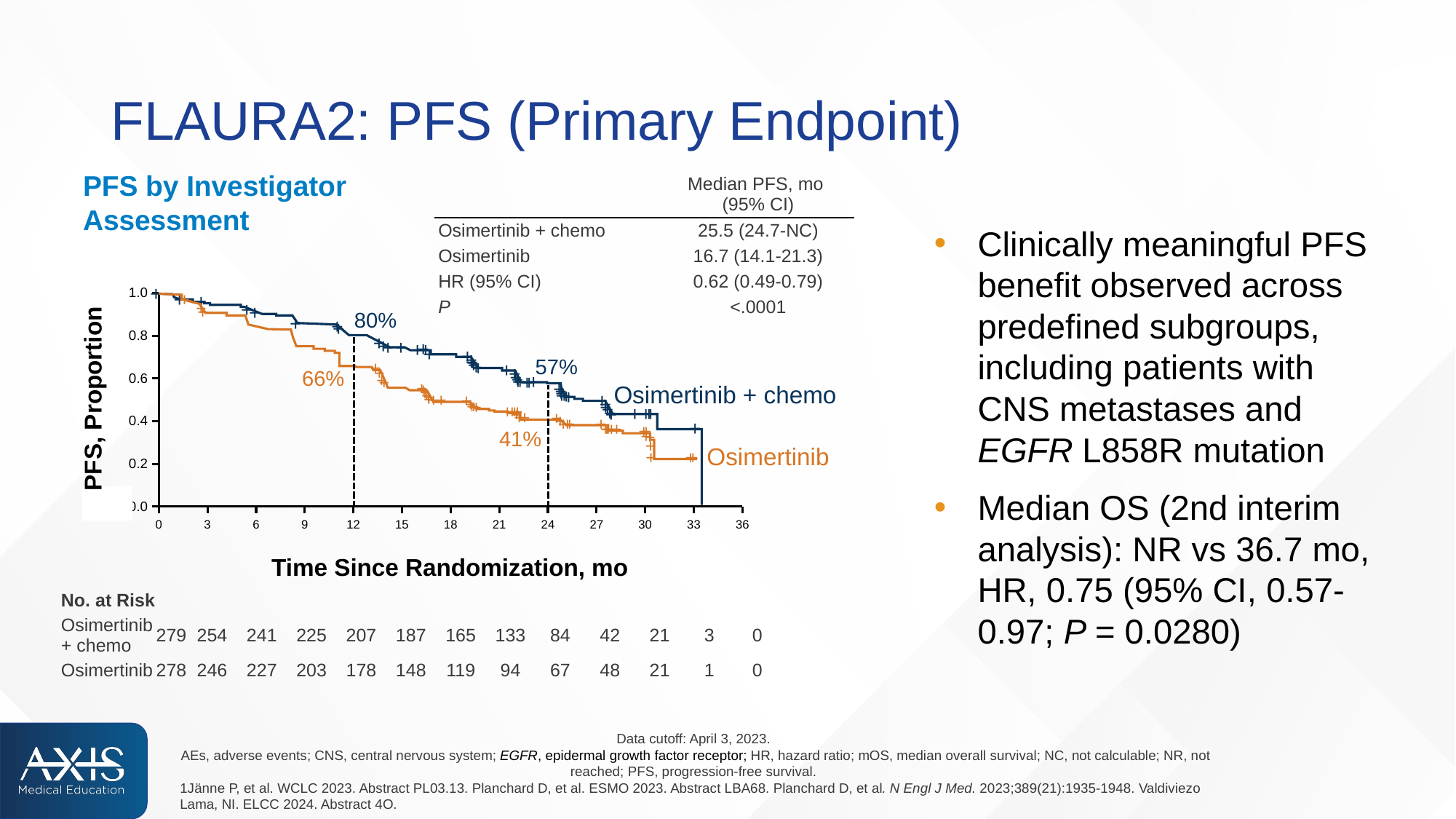
How many treatment arms (curves) are plotted on the chart? 2 At 24 months, which arm has the higher labeled PFS proportion? Osimertinib + chemo What is the difference in labeled PFS proportion between Osimertinib + chemo and Osimertinib at 24 months? 16 percentage points What is the median PFS for the Osimertinib + chemo arm shown in the table? 25.5 (24.7-NC) What is the label of the x axis of the chart? Time Since Randomization, mo What is the difference in labeled PFS proportion between Osimertinib + chemo and Osimertinib at 12 months? 14 percentage points Do the PFS curves rise or fall as time since randomization increases? Fall What PFS proportion is labeled for the Osimertinib + chemo curve at 12 months? 80% What kind of chart is shown on the slide? Line chart (Kaplan-Meier curve) How many patients were at risk in the Osimertinib arm at 18 months? 119 Is the Osimertinib curve at 33 months greater or less than 0.4? less What PFS proportion is labeled for the Osimertinib curve at 24 months? 41%